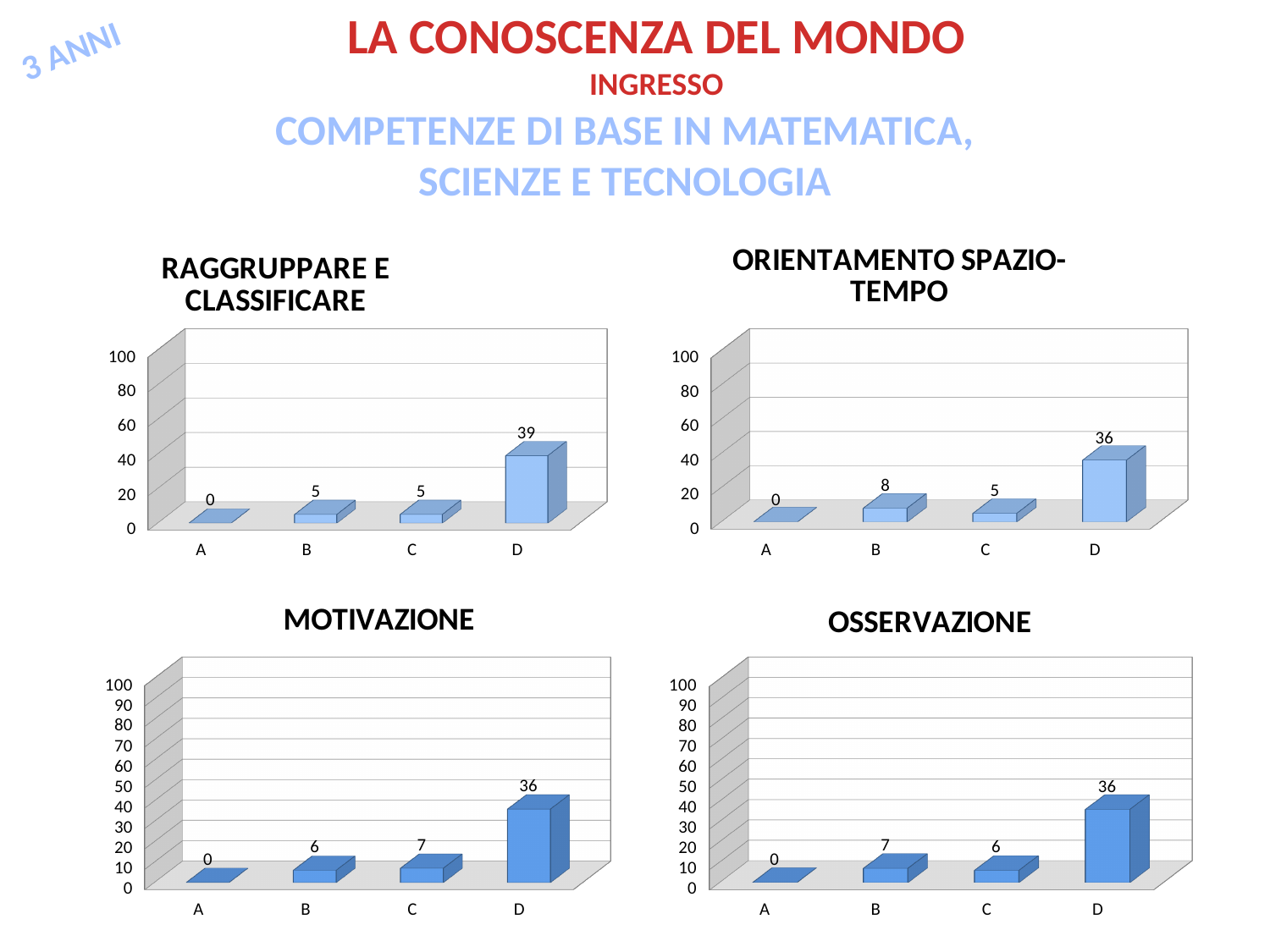
In the MOTIVAZIONE chart, which category has the lowest value? A In the OSSERVAZIONE chart, which is larger, the value for B or the value for C? B In the OSSERVAZIONE chart, which category has the highest value? D In the MOTIVAZIONE chart, what is the value for C? 7 In the OSSERVAZIONE chart, what is the value for A? 0 In the RAGGRUPPARE E CLASSIFICARE chart, what is the value for D? 39 In the ORIENTAMENTO SPAZIO-TEMPO chart, what is the difference between the values for D and B? 28 In the RAGGRUPPARE E CLASSIFICARE chart, what is the difference between the values for D and C? 34 In the ORIENTAMENTO SPAZIO-TEMPO chart, what is the value for B? 8 What kind of chart is the RAGGRUPPARE E CLASSIFICARE chart? bar chart How many categories are shown in the ORIENTAMENTO SPAZIO-TEMPO chart? 4 In the MOTIVAZIONE chart, is the value for D greater or less than 20? greater